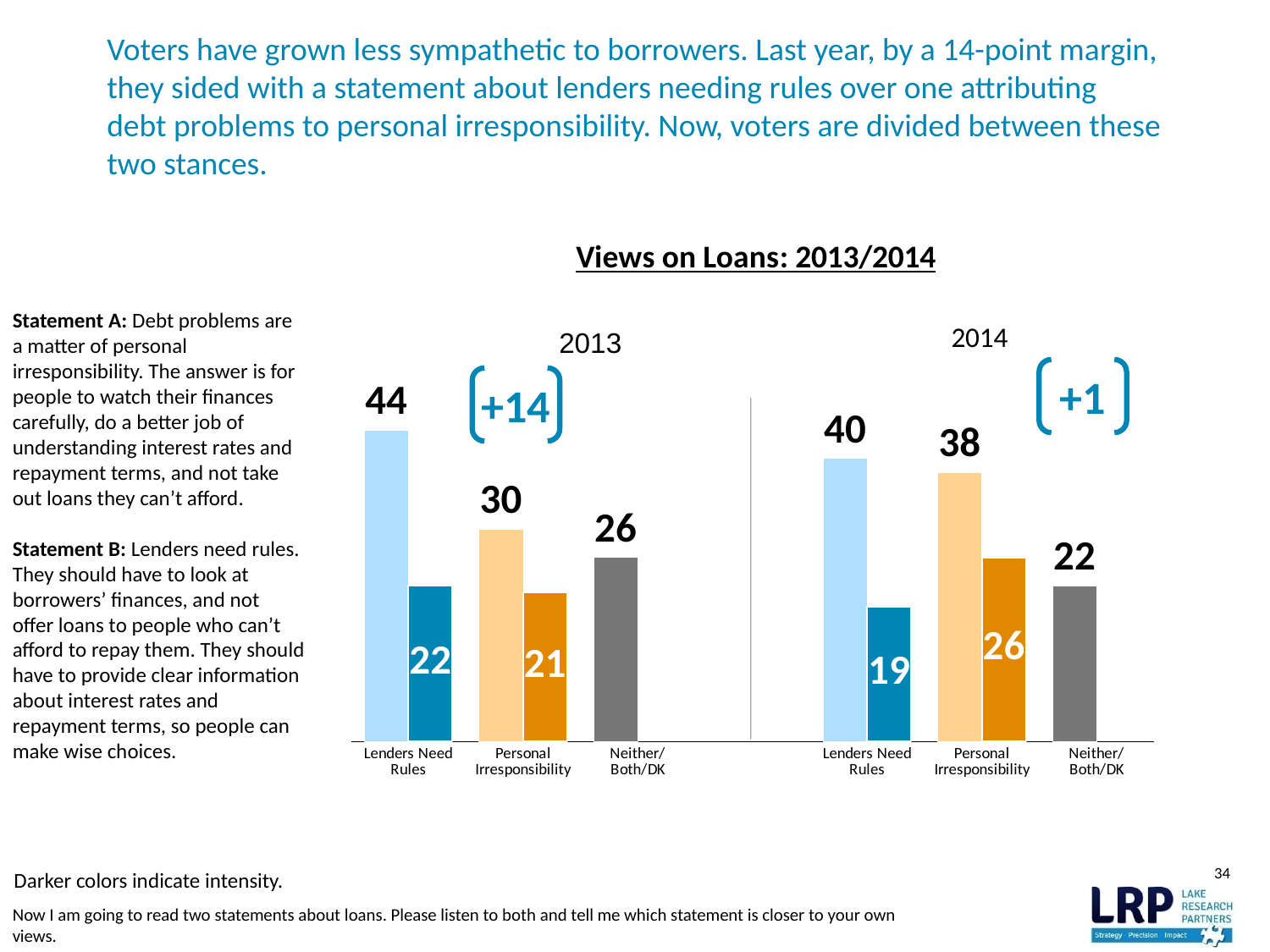
In the 2013 section of the Views on Loans chart, which category has the highest value? Lenders Need Rules In the 2013 section of the Views on Loans chart, what is the value for Lenders Need Rules? 44 In the 2014 section of the Views on Loans chart, what is the value shown on the darker bar for Lenders Need Rules? 19 In the 2013 section of the Views on Loans chart, what is the difference between Lenders Need Rules (44) and Personal Irresponsibility (30)? 14 In the 2013 section of the Views on Loans chart, what is the value for Neither/Both/DK? 26 In the 2014 section of the Views on Loans chart, what is the value for Personal Irresponsibility? 38 How many categories are shown on the x axis in each year section of the Views on Loans chart? 3 In the Views on Loans chart, is the value for Personal Irresponsibility larger in 2013 or in 2014? 2014 In the 2014 section of the Views on Loans chart, what is the difference between Lenders Need Rules (40) and Personal Irresponsibility (38)? 2 What type of chart is the Views on Loans: 2013/2014 chart? Bar chart What margin is shown in the bracket above the 2014 section of the Views on Loans chart? +1 In the 2014 section of the Views on Loans chart, which category has the lowest value? Neither/Both/DK